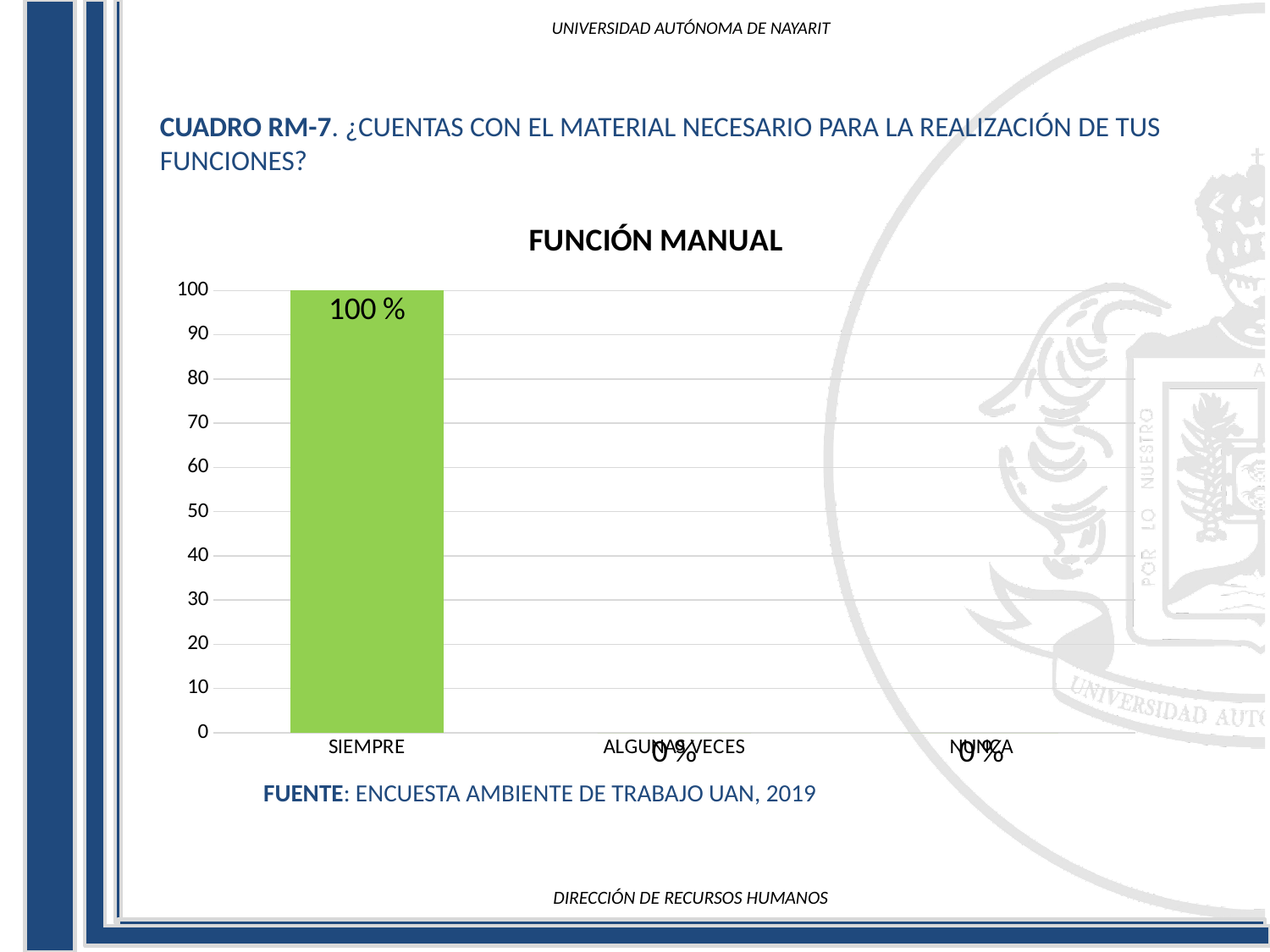
What is the value for NUNCA? 0 % What is the difference between the values for SIEMPRE and NUNCA? 100 % What is the value for SIEMPRE? 100 % What kind of chart is shown? bar chart What is the highest value shown on the y axis? 100 How many categories are shown on the x axis? 3 What is the title of the chart? FUNCIÓN MANUAL Which is larger, the value for SIEMPRE or the value for ALGUNAS VECES? SIEMPRE Is the value for SIEMPRE greater or less than 50? greater What is the value for ALGUNAS VECES? 0 % Which category has the highest value? SIEMPRE What colour is the bar for SIEMPRE? green